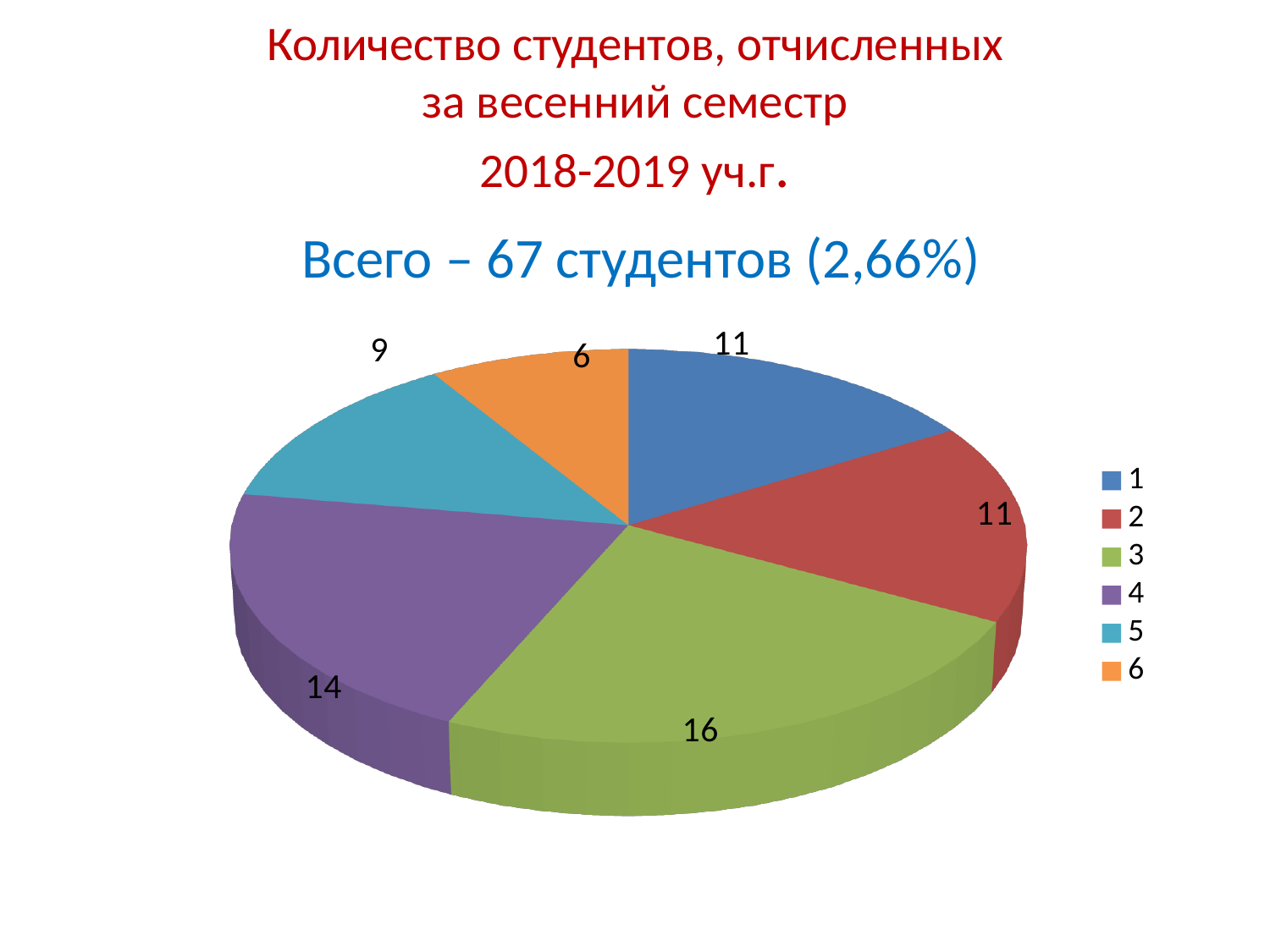
How many slices does the pie chart have? 6 What is the value for category 6? 6 What is the value for category 4? 14 What is the value for category 5? 9 What is the difference between the values for category 3 and category 6? 10 Which category has the largest slice? 3 Which is larger, the value for category 4 or the value for category 5? category 4 What is the total number of students across all slices of the pie chart? 67 How many entries does the legend list? 6 What type of chart is shown on the slide? pie chart What is the value for category 3? 16 Which category has the smallest slice? 6